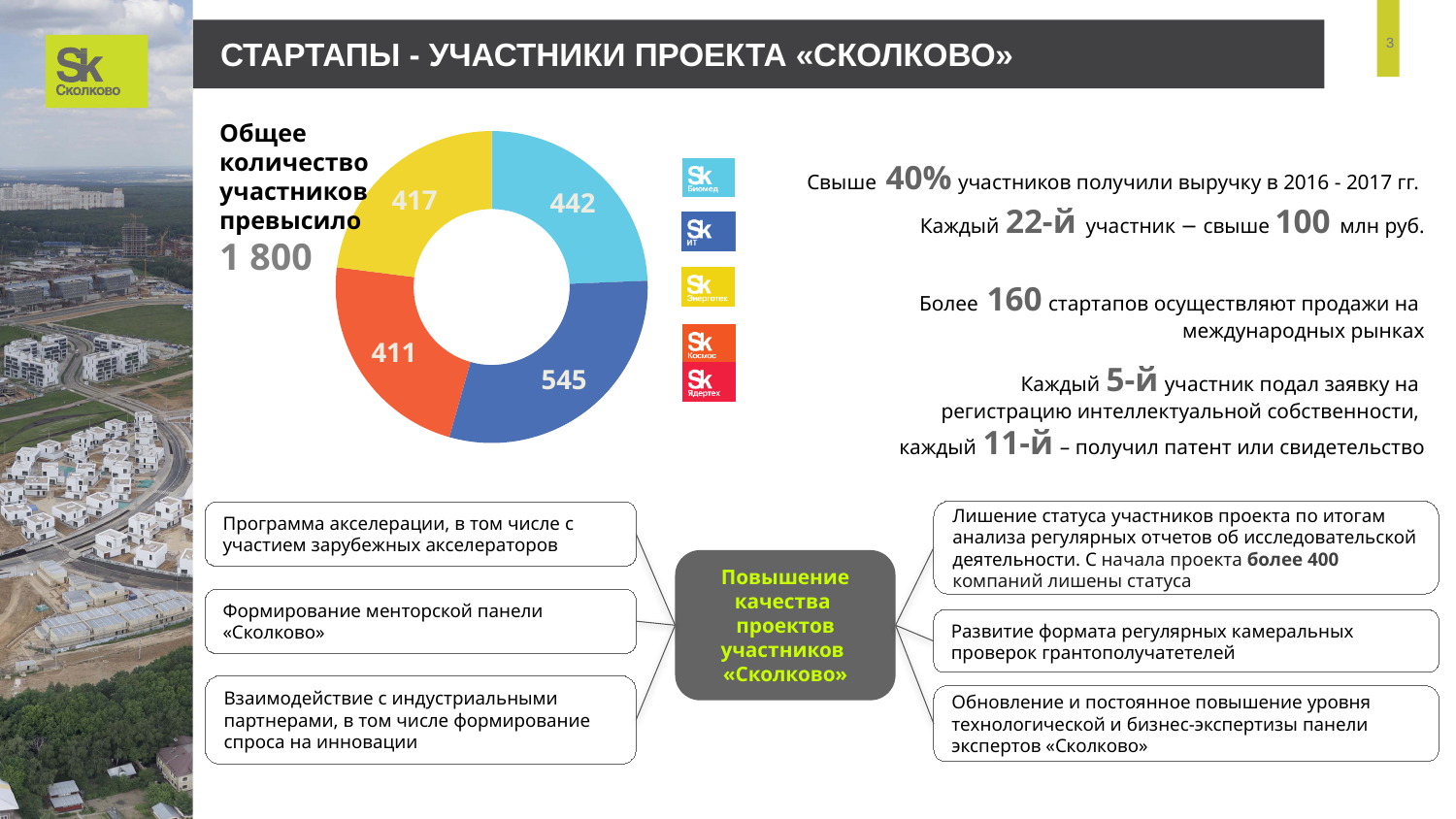
What is the smallest value shown on the donut chart? 411 What is the value of the red/orange slice of the donut chart? 411 What is the difference between the largest slice (545) and the light blue slice (442)? 103 What is the value of the light blue slice of the donut chart? 442 What is the value of the yellow slice of the donut chart? 417 Which is larger: the light blue slice or the yellow slice? the light blue slice (442) According to the text next to the chart, what number did the total number of participants exceed? 1 800 What kind of chart is shown on the slide? pie (donut) chart How many slices does the donut chart have? 4 What is the difference between the yellow slice (417) and the red slice (411)? 6 What is the largest value shown on the donut chart? 545 What is the total of all four slice values on the donut chart? 1815